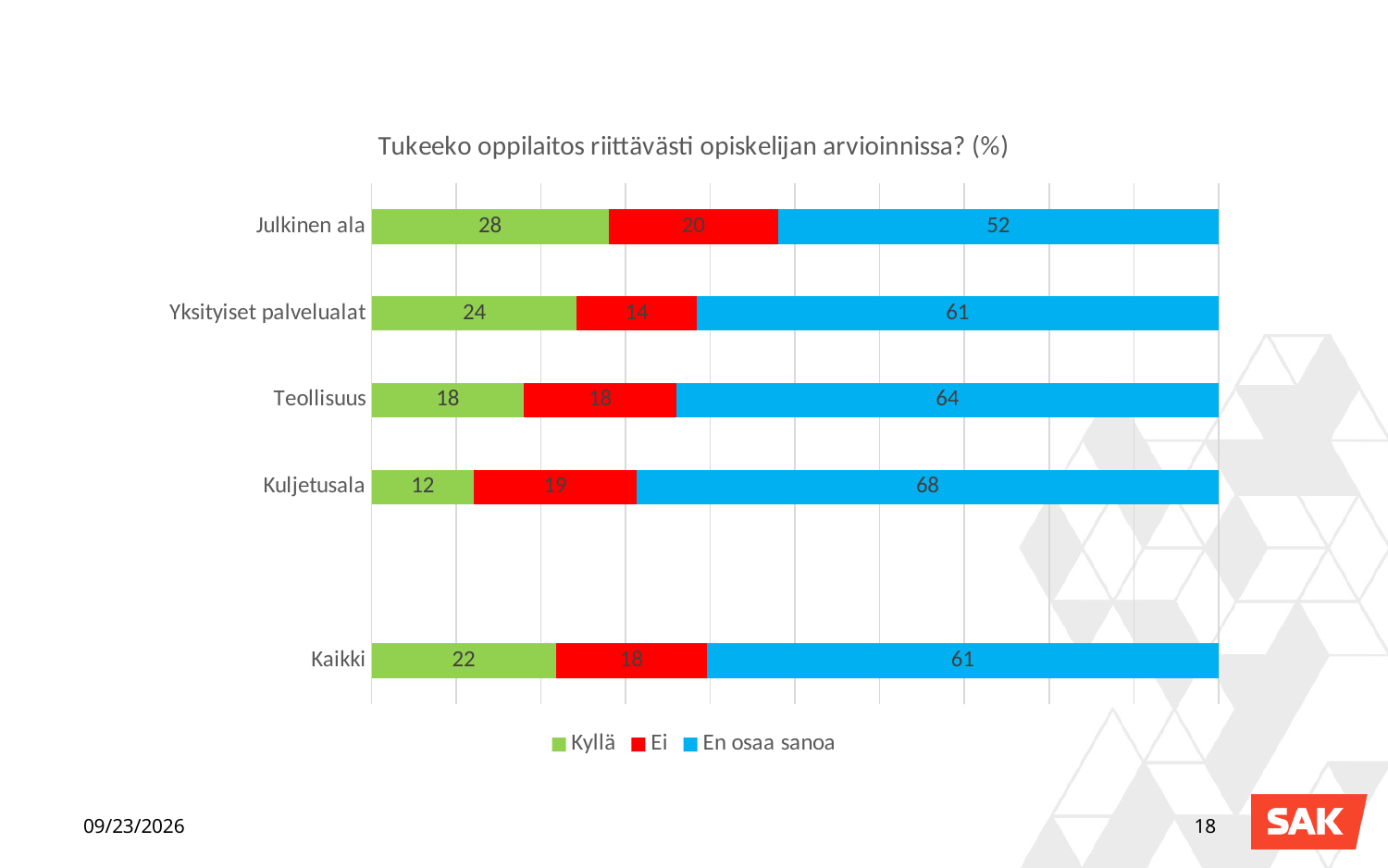
Which category has the highest Kyllä value? Julkinen ala What is the Ei value for Yksityiset palvelualat? 14 Which category has the lowest Ei value? Yksityiset palvelualat How many categories are shown on the chart? 5 What is the Kyllä value for Julkinen ala? 28 What is the En osaa sanoa value for Kuljetusala? 68 Which category has the lowest Kyllä value? Kuljetusala How many series does the legend list? 3 Which is larger, the Kyllä value for Teollisuus or the Kyllä value for Kaikki? Kaikki What is the total of the stacked bar for Teollisuus? 100 What kind of chart is shown on the slide? Stacked bar chart What is the difference between the En osaa sanoa values for Kuljetusala and Julkinen ala? 16